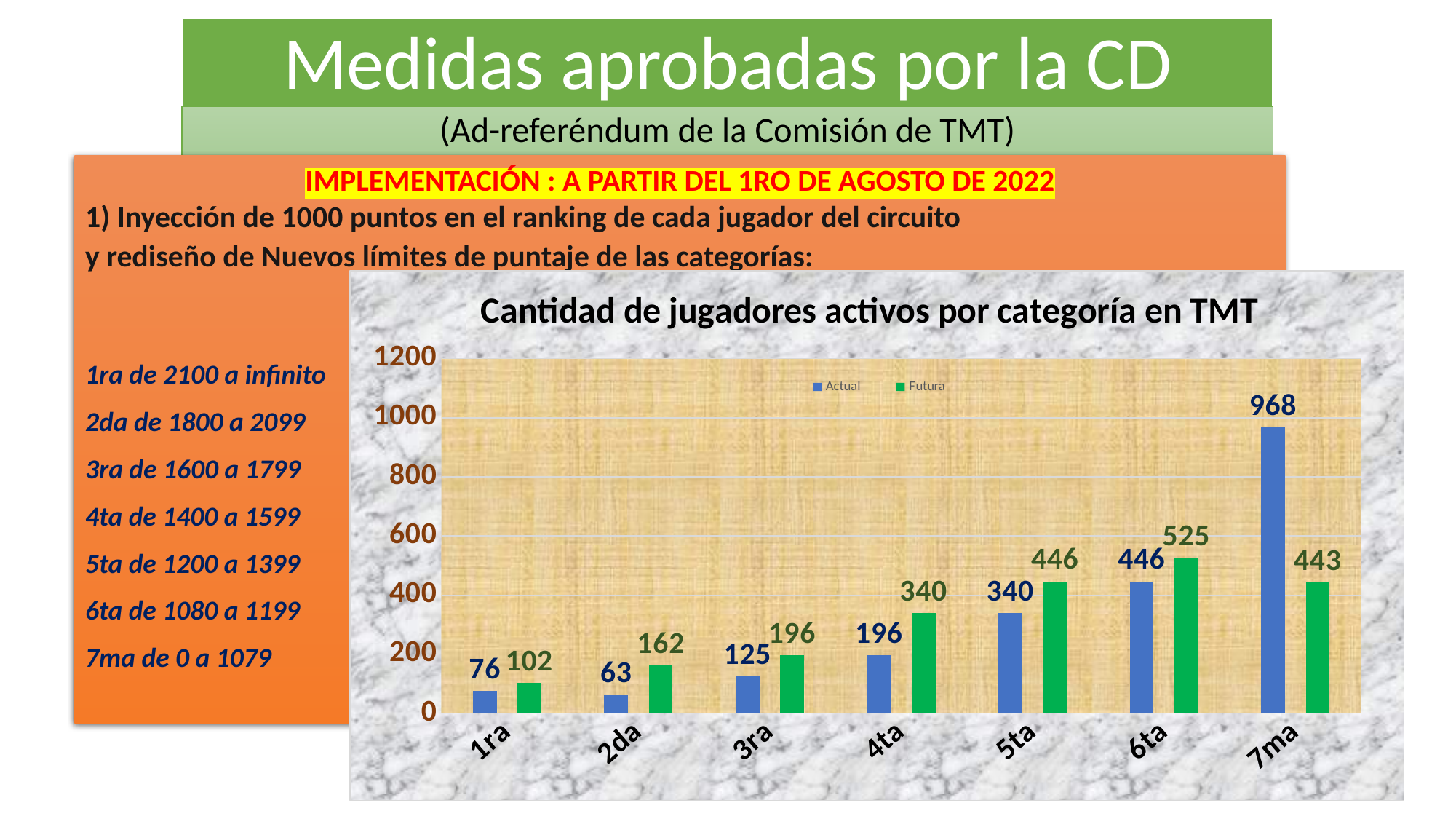
What is the Futura value for the 3ra category? 196 Which category has the lowest Actual value? 2da What is the Actual value for the 2da category? 63 How many series does the legend list? 2 How many categories are shown on the x axis? 7 Is the Actual value for 7ma greater or less than 800? greater Which is larger for the 5ta category, the Actual value or the Futura value? Futura What is the title of the chart? Cantidad de jugadores activos por categoría en TMT Which category has the highest Futura value? 6ta What is the difference between the Actual and Futura values for the 7ma category? 525 What kind of chart is shown on the slide? bar chart What is the Actual value for the 7ma category? 968